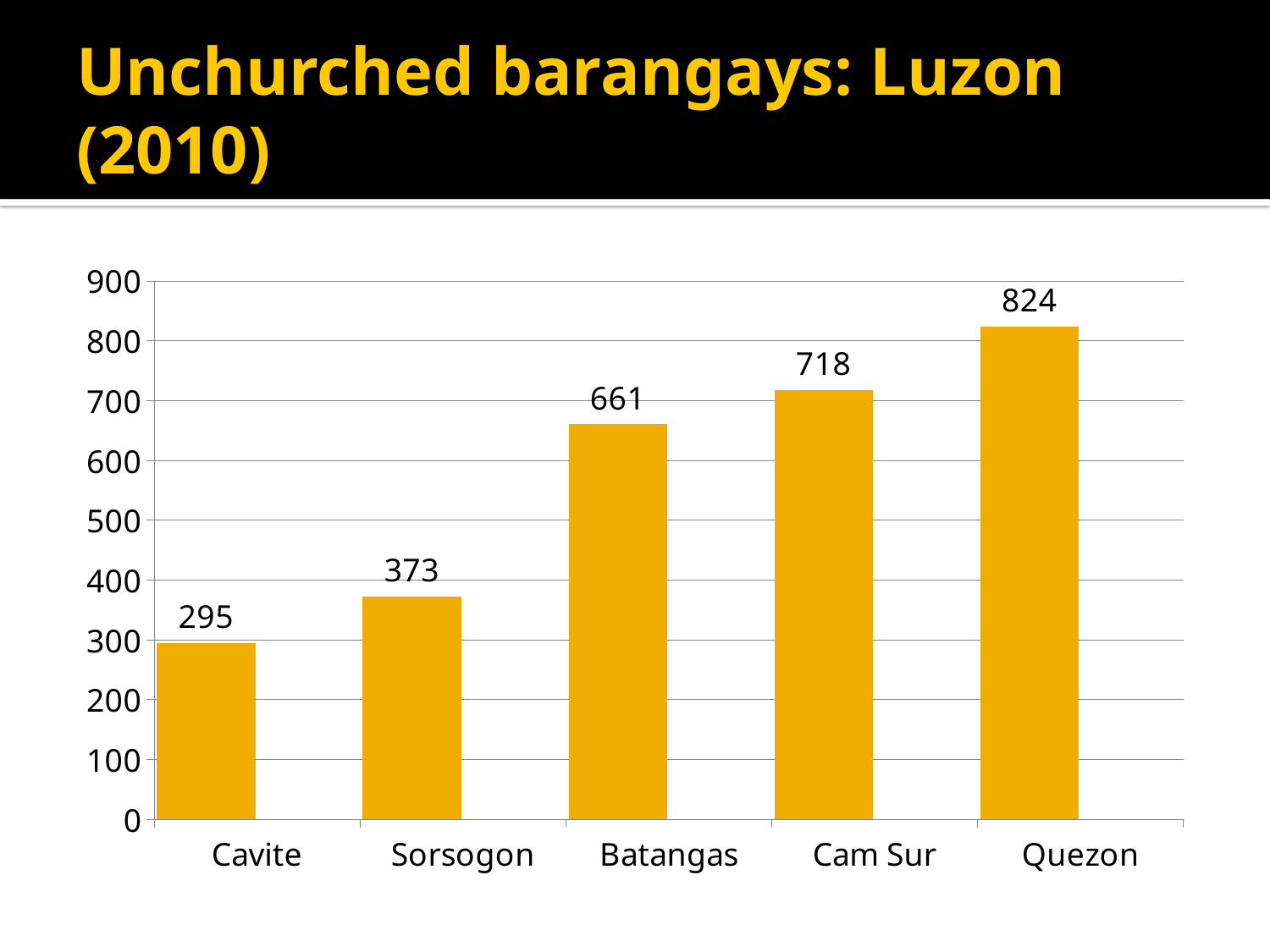
What kind of chart is shown on the slide? bar chart Which province has the highest value? Quezon Which is larger, the value for Sorsogon or the value for Batangas? Batangas What is the value for Batangas? 661 What is the difference between the values for Cam Sur and Batangas? 57 How many provinces are shown on the chart? 5 What is the difference between the values for Quezon and Cavite? 529 What is the value for Cam Sur? 718 Do the values rise or fall from Cavite to Quezon along the x axis? rise Is the value for Sorsogon greater or less than 400? less What is the value for Cavite? 295 Which province has the lowest value? Cavite